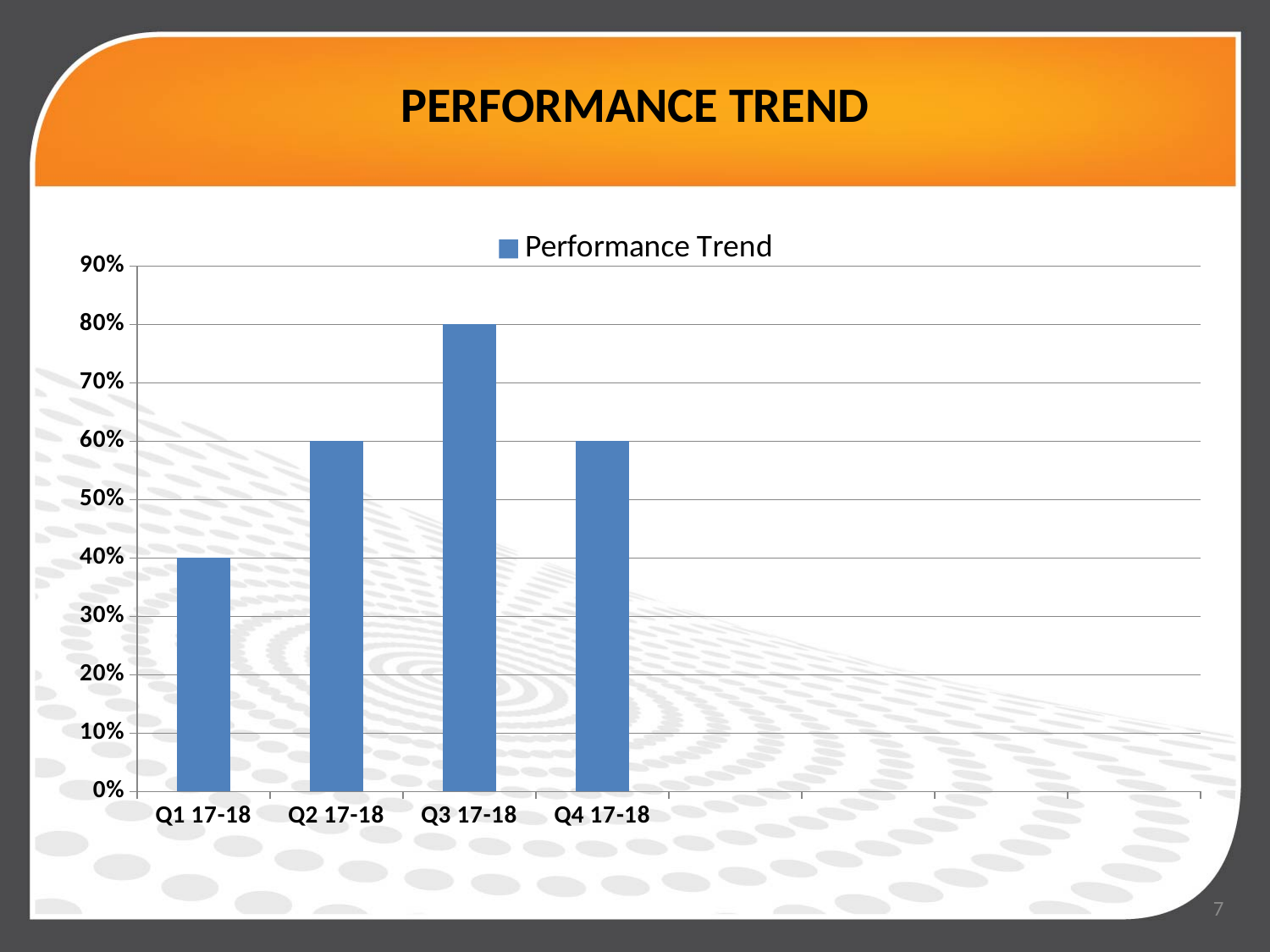
Which is larger, the value for Q2 17-18 or the value for Q1 17-18? Q2 17-18 How many series does the legend list? 1 What is the value for Q1 17-18? 40% What is the value for Q3 17-18? 80% Which quarter has the highest value? Q3 17-18 What is the difference between the values for Q3 17-18 and Q1 17-18? 40% How many quarters are plotted on the chart? 4 Is the value for Q4 17-18 greater or less than 50%? greater What is the value for Q2 17-18? 60% Which quarter has the lowest value? Q1 17-18 What type of chart is shown on the slide? bar chart What is the name of the series shown in the legend? Performance Trend